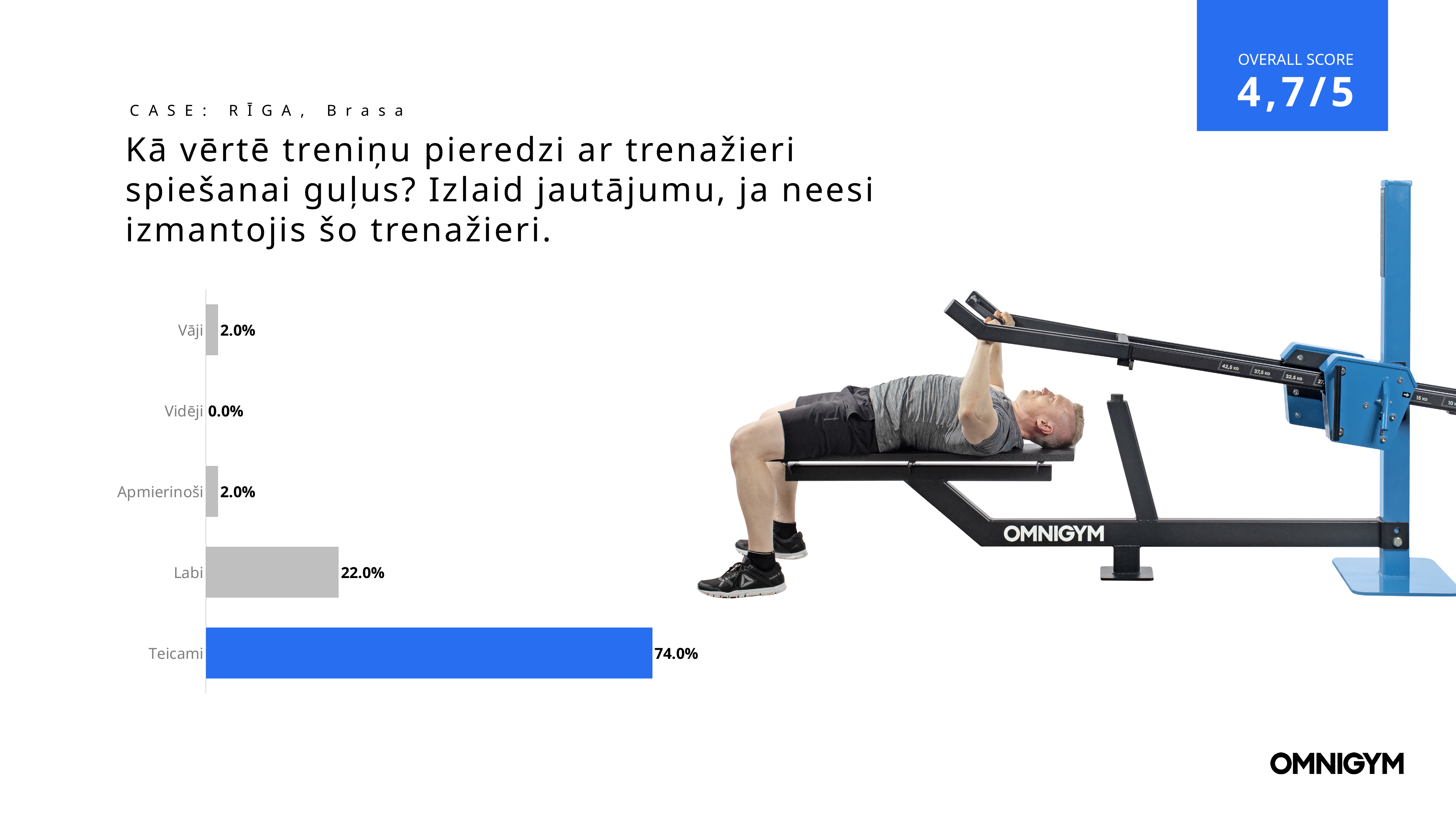
What is the value for Labi? 22.0% Which category has the lowest value? Vidēji What is the value for Vidēji? 0.0% Which bar is coloured blue rather than grey? Teicami What is the combined value of Vāji and Apmierinoši? 4.0% What is the difference between the values for Teicami and Labi? 52.0% Which is larger, the value for Labi or the value for Apmierinoši? Labi What kind of chart is shown on the slide? Bar chart Which category has the highest value? Teicami What is the value for Apmierinoši? 2.0% What is the value for Teicami? 74.0% How many categories are shown in the chart? 5